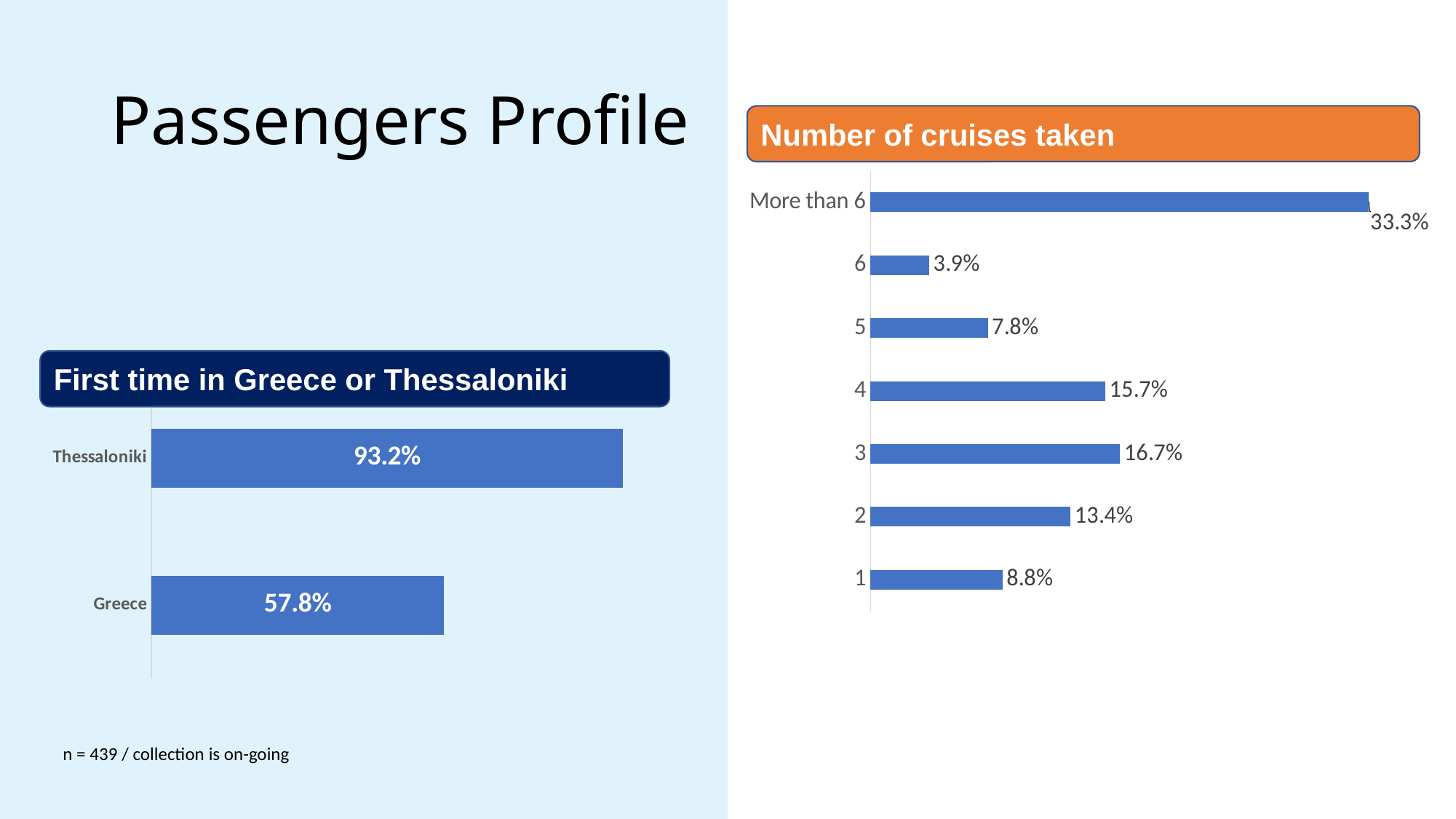
In the 'Number of cruises taken' chart, what is the difference between the values for 1 cruise and 5 cruises? 1.0% In the 'First time in Greece or Thessaloniki' chart, what is the value for Thessaloniki? 93.2% In the 'Number of cruises taken' chart, what is the value for 3 cruises? 16.7% What type of chart is the 'Number of cruises taken' chart? Bar chart In the 'First time in Greece or Thessaloniki' chart, how many categories are shown? 2 In the 'First time in Greece or Thessaloniki' chart, what is the difference between the Thessaloniki and Greece values? 35.4% In the 'First time in Greece or Thessaloniki' chart, what is the value for Greece? 57.8% In the 'Number of cruises taken' chart, which is larger: the value for 2 cruises or the value for 4 cruises? 4 In the 'Number of cruises taken' chart, which category has the highest value? More than 6 In the 'Number of cruises taken' chart, how many categories are shown? 7 In the 'Number of cruises taken' chart, what is the value for 'More than 6'? 33.3% In the 'Number of cruises taken' chart, which category has the lowest value? 6